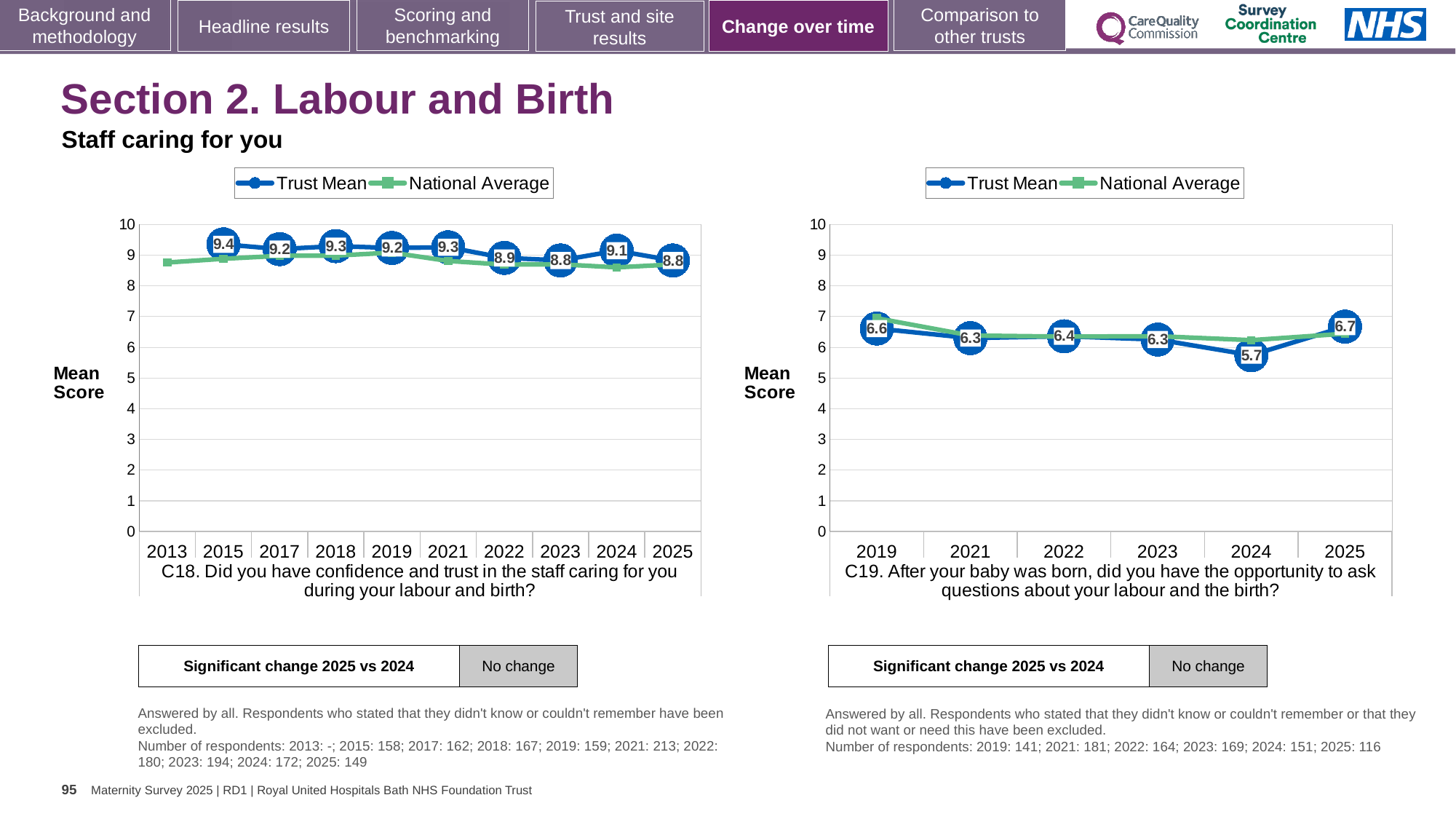
In the C18 chart on the left, what is the Trust Mean for 2015? 9.4 How many series does the legend of the C18 chart on the left list? 2 How many years are shown on the x axis of the C19 chart on the right? 6 What type of chart is the C19 chart on the right? Line chart In the C19 chart on the right, what is the difference between the Trust Mean in 2025 and in 2024? 1.0 In the C18 chart on the left, is the Trust Mean higher in 2024 or in 2025? 2024 In the C18 chart on the left, what is the Trust Mean for 2025? 8.8 In the C18 chart on the left, which year has the highest Trust Mean? 2015 In the C18 chart on the left, is the National Average for 2013 greater or less than 9? less In the C19 chart on the right, what is the Trust Mean for 2024? 5.7 In the C19 chart on the right, which year has the lowest Trust Mean? 2024 In the C19 chart on the right, which year has the highest Trust Mean? 2025